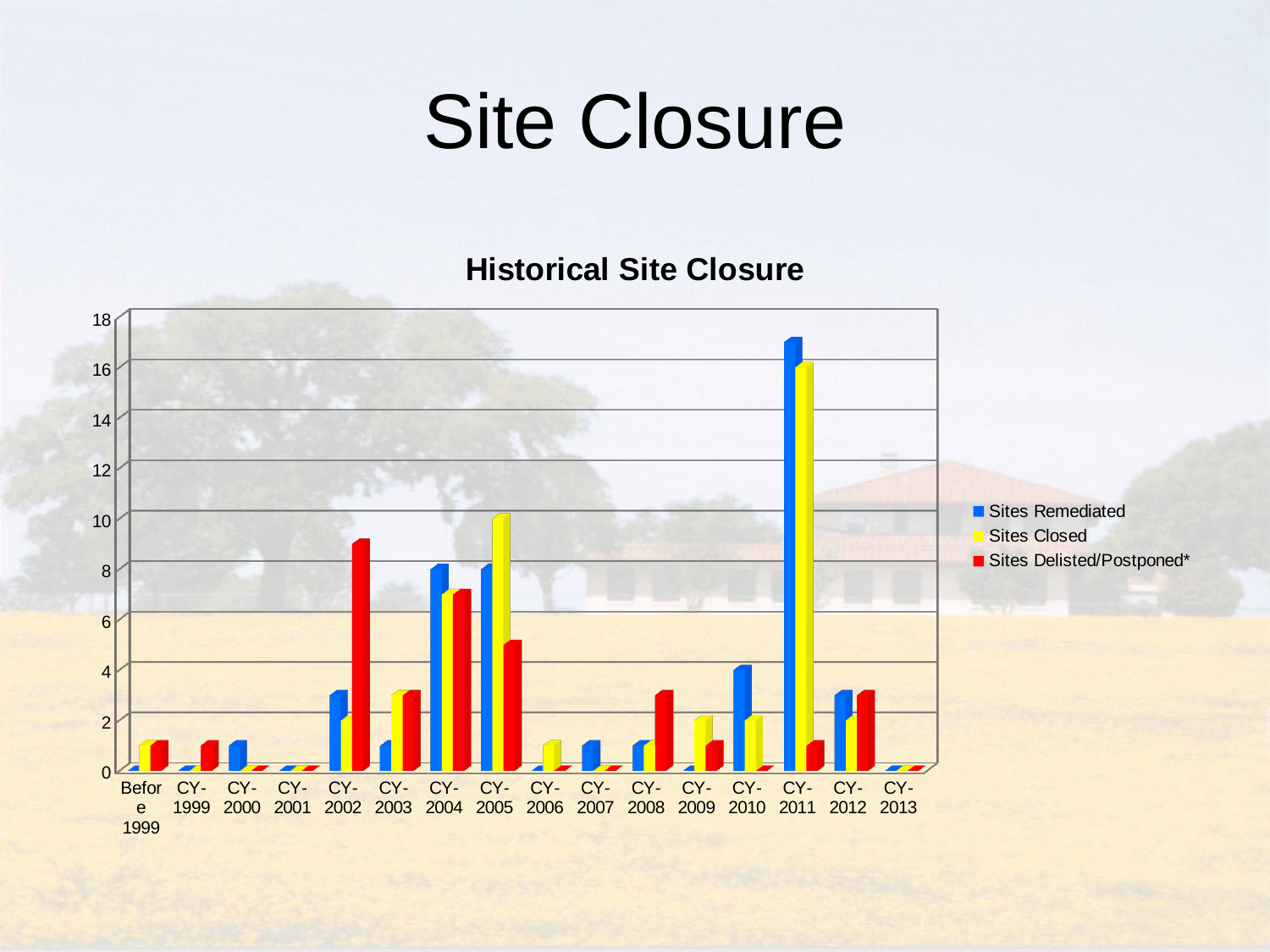
Which colour represents the Sites Closed series? Yellow How many series does the legend list? 3 Which is larger, the Sites Delisted/Postponed* value for CY-2002 or for CY-2003? CY-2002 Is the Sites Closed value for CY-2005 greater or less than 8? greater In which year is the Sites Delisted/Postponed* value highest? CY-2002 How many categories are shown along the x axis? 16 In which year is the Sites Remediated value highest? CY-2011 What is the title of the chart? Historical Site Closure Is the Sites Remediated value for CY-2011 greater or less than 14? greater What kind of chart is shown on the slide? Bar chart Is the Sites Remediated value for CY-2010 greater or less than 6? less In which year is the Sites Closed value highest? CY-2011